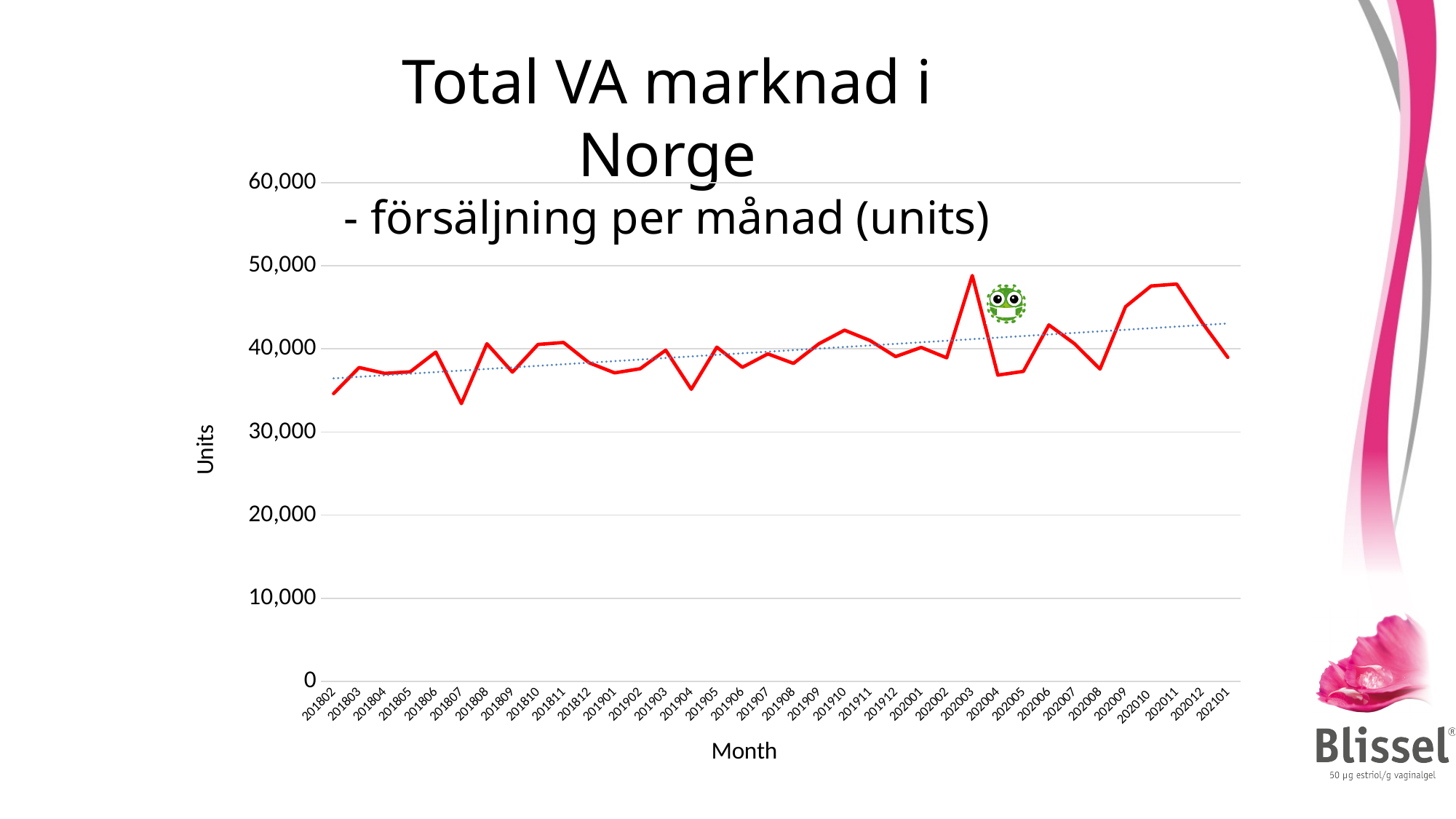
Is the value for 201807 greater or less than 40,000? less How many monthly data points are plotted on the chart? 36 Which month has the highest value on the chart? 202003 Which is larger, the value for 202003 or the value for 202004? 202003 What is the label of the vertical axis? Units Is the value for 202003 greater or less than 40,000? greater What is the title of the chart? Total VA marknad i Norge - försäljning per månad (units) Is the value for 201904 greater or less than 40,000? less Which is larger, the value for 202011 or the value for 201807? 202011 What kind of chart is shown on the slide? line chart Does the dotted trend line rise or fall from left to right across the months? rise